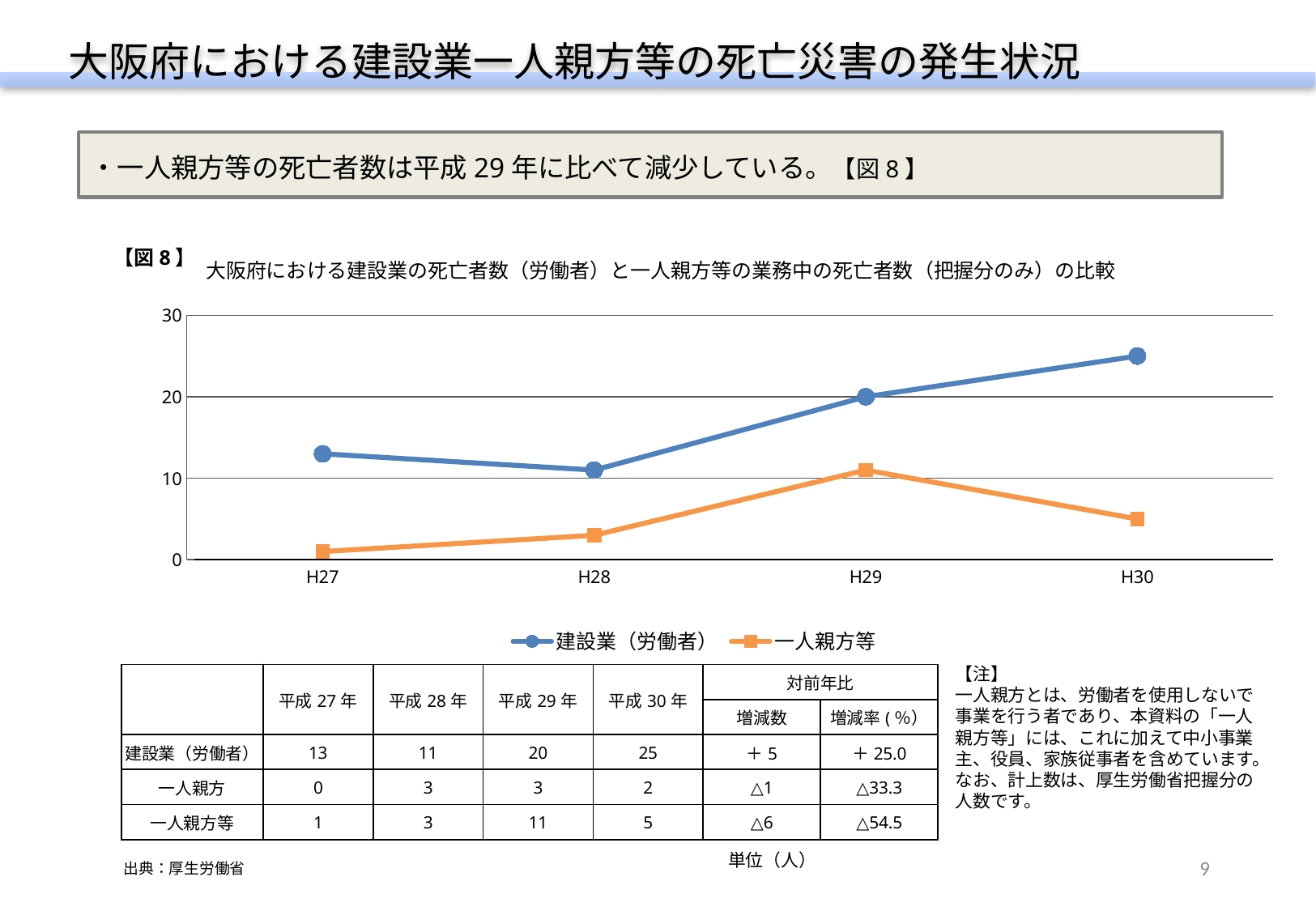
What is the value for 一人親方等 in H29? 11 Which series has the larger value in H27, 建設業（労働者） or 一人親方等? 建設業（労働者） In which year is the 建設業（労働者） series lowest? H28 Does the 一人親方等 series rise or fall from H29 to H30? fall In which year is the 一人親方等 series highest? H29 What colour is the line for 一人親方等? orange What kind of chart is shown in 図8? line chart What is the value for 建設業（労働者） in H30? 25 How many years are plotted along the x axis of the chart? 4 What is the difference between 建設業（労働者） and 一人親方等 in H30? 20 How many series does the legend of the chart list? 2 Is the value for 建設業（労働者） in H29 greater or less than 10? greater